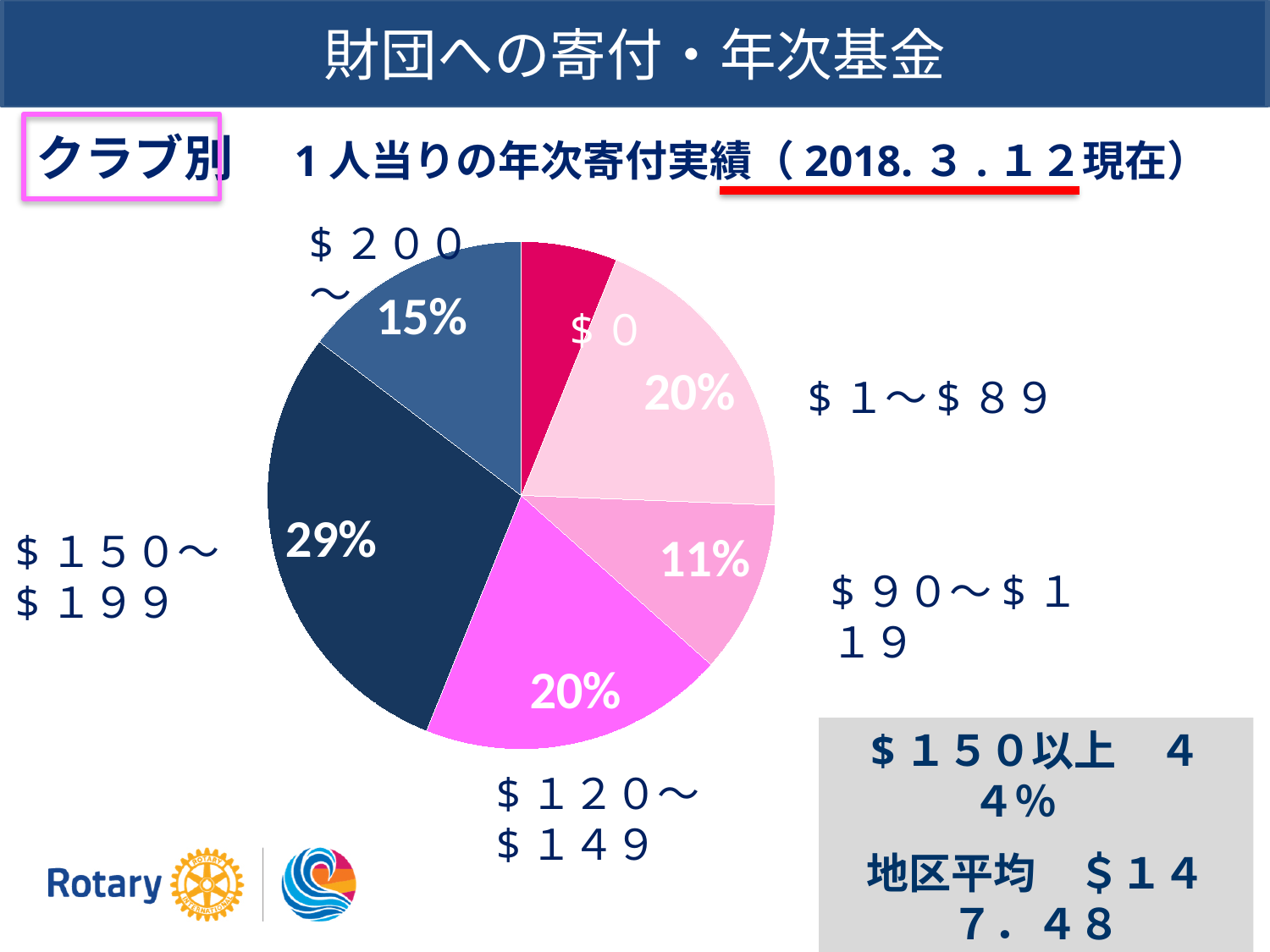
What kind of chart is shown on the slide? pie chart What percentage of clubs fall in the $200～ range? 15% What percentage of clubs fall in the $150～$199 range? 29% What percentage of clubs fall in the $90～$119 range? 11% What percentage of clubs fall in the $120～$149 range? 20% What is the difference in percentage points between the $150～$199 slice and the $200～ slice? 14 Which range has the largest share of the pie? $150～$199 What is the combined percentage of the $150～$199 and $200～ slices? 44% How many slices does the pie chart have? 6 Which range has the smaller share: $90～$119 or $200～? $90～$119 What percentage of clubs fall in the $1～$89 range? 20% What date is given in the chart heading for the per-person annual giving figures? 2018.3.12